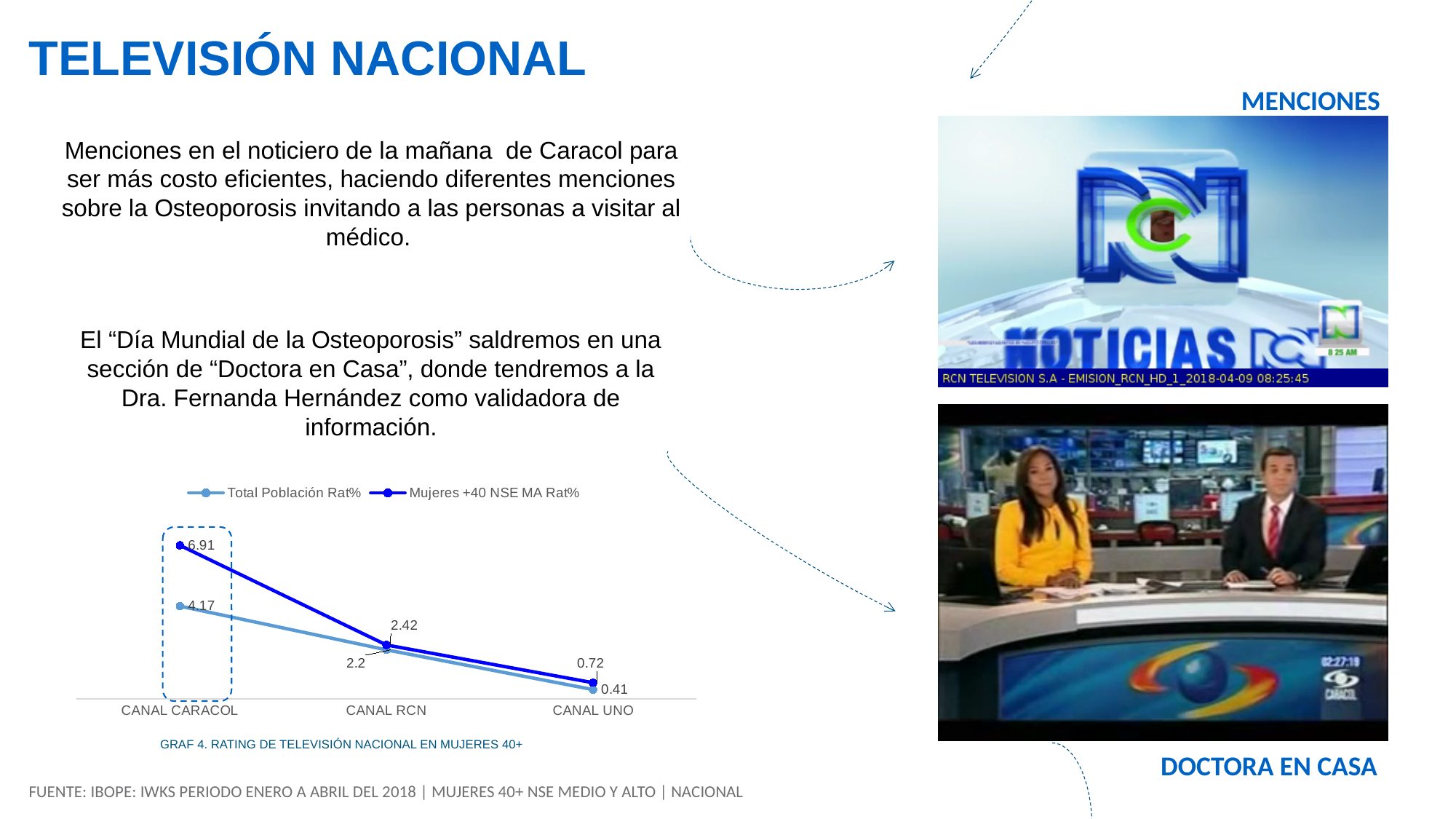
How many channels are shown on the x axis of the chart? 3 Which channel has the lowest Total Población Rat% value? CANAL UNO What is the value of Total Población Rat% for CANAL CARACOL? 4.17 What is the value of Mujeres +40 NSE MA Rat% for CANAL RCN? 2.42 For CANAL UNO, which series has the larger value: Total Población Rat% or Mujeres +40 NSE MA Rat%? Mujeres +40 NSE MA Rat% What is the value of Mujeres +40 NSE MA Rat% for CANAL CARACOL? 6.91 What is the difference between the Mujeres +40 NSE MA Rat% and Total Población Rat% values for CANAL CARACOL? 2.74 How many series does the chart legend list? 2 What kind of chart is shown on the slide? Line chart What is the value of Total Población Rat% for CANAL UNO? 0.41 Do the Mujeres +40 NSE MA Rat% values rise or fall from CANAL CARACOL to CANAL UNO? Fall Which channel has the highest Mujeres +40 NSE MA Rat% value? CANAL CARACOL